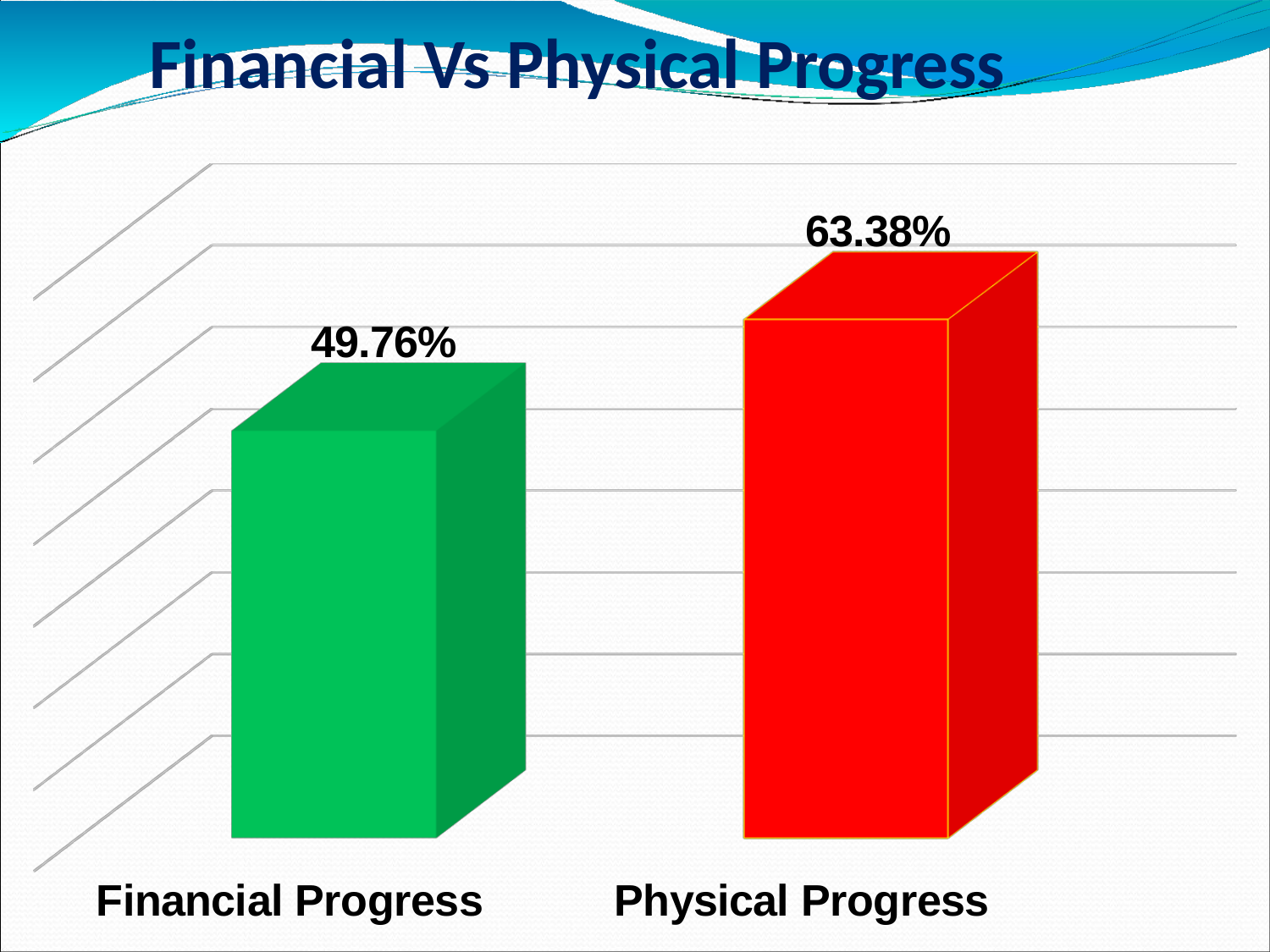
What is the value for Financial Progress? 49.76% Which is larger, Financial Progress or Physical Progress? Physical Progress Which category has the highest value? Physical Progress What colour is the Physical Progress bar? Red How many categories are shown in the chart? 2 What kind of chart is shown on the slide? Bar chart What is the title of the slide? Financial Vs Physical Progress What is the value for Physical Progress? 63.38% What is the difference between the Physical Progress and Financial Progress values? 13.62% Which category has the lowest value? Financial Progress